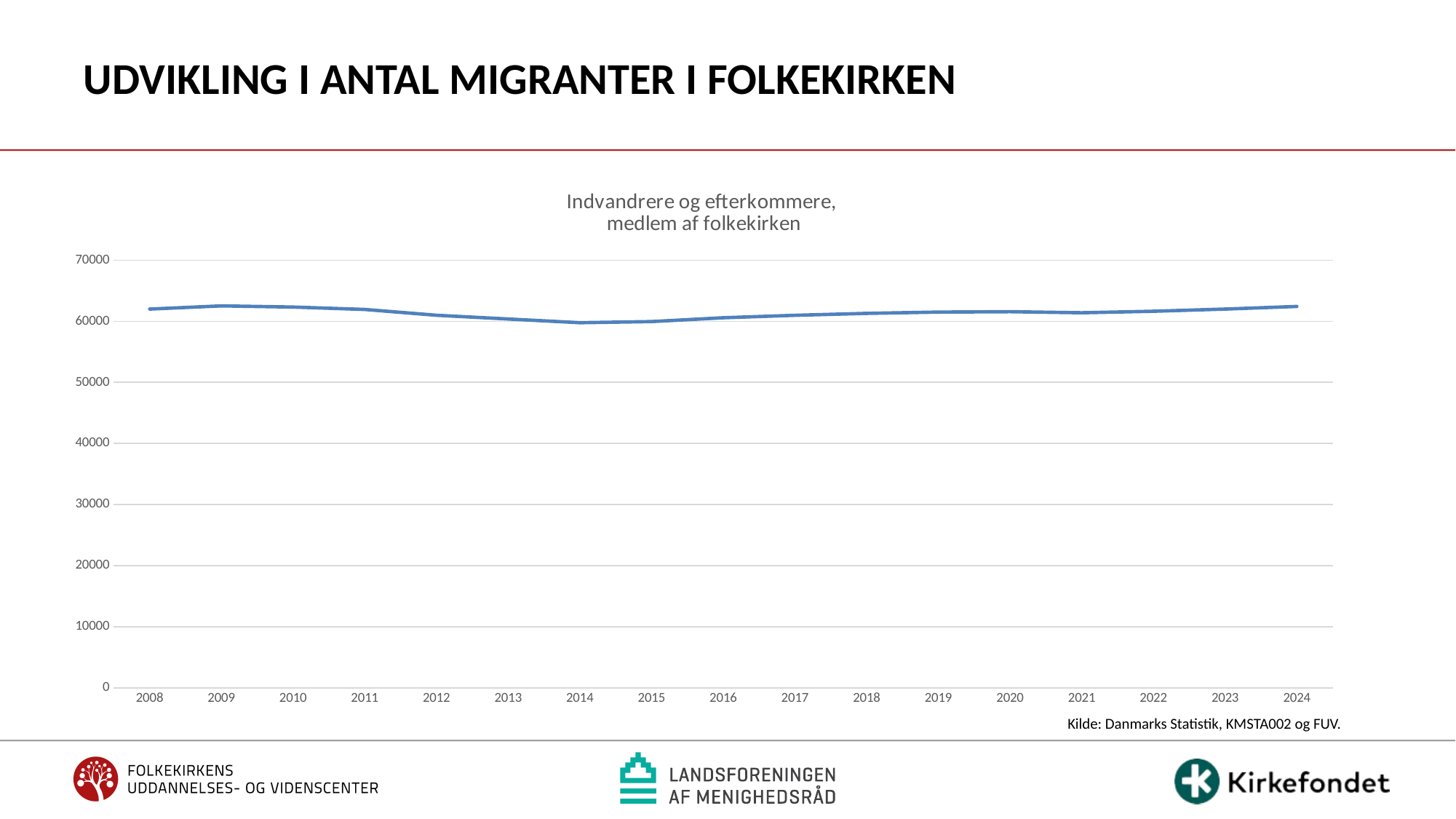
Which is larger, the value for 2014 or the value for 2024? 2024 Do the values rise or fall from 2014 to 2024? rise Which is larger, the value for 2009 or the value for 2014? 2009 What is the title of the chart? Indvandrere og efterkommere, medlem af folkekirken Do the values rise or fall from 2009 to 2014? fall Is the value for 2008 greater or less than 70000? less Which year has the lowest value on the chart? 2014 What is the first year shown on the x axis? 2008 Is the value for 2014 greater or less than 50000? greater Is the value for 2024 greater or less than 60000? greater What kind of chart is shown on the slide? line chart How many years are shown on the x axis of the chart? 17